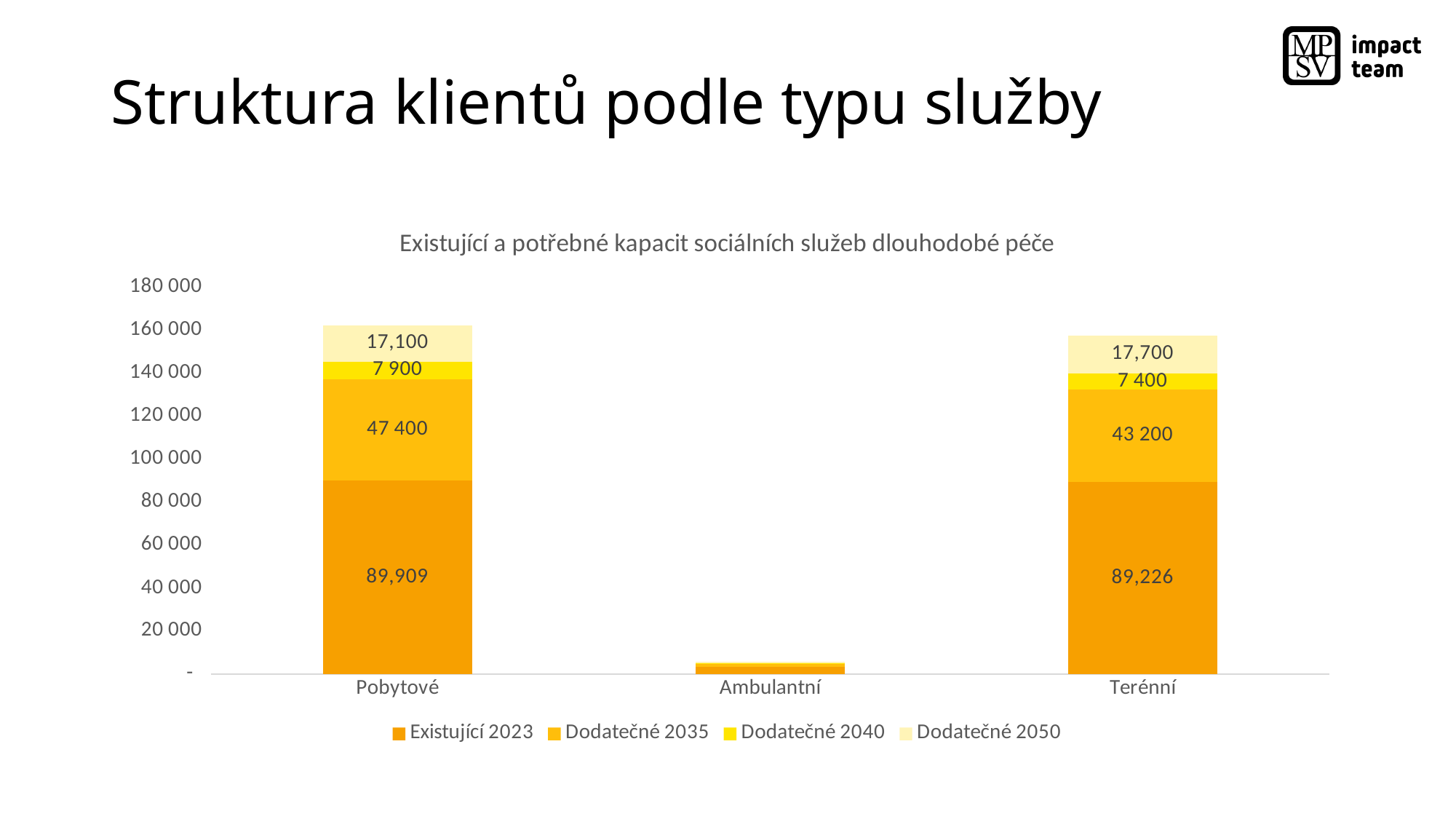
How many series does the legend list? 4 Is the total value for Ambulantní greater or less than 20 000? less How many categories are shown on the x axis? 3 Which category has the lowest total capacity? Ambulantní What is the Dodatečné 2035 value for Terénní? 43 200 What type of chart is shown on the slide? stacked bar chart Which is larger, the Dodatečné 2050 value for Pobytové or for Terénní? Terénní What is the difference between the Dodatečné 2035 values for Pobytové and Terénní? 4 200 What is the title of the chart? Existující a potřebné kapacit sociálních služeb dlouhodobé péče What is the Existující 2023 value for Pobytové? 89,909 What is the Dodatečné 2040 value for Pobytové? 7 900 What is the Dodatečné 2050 value for Terénní? 17,700